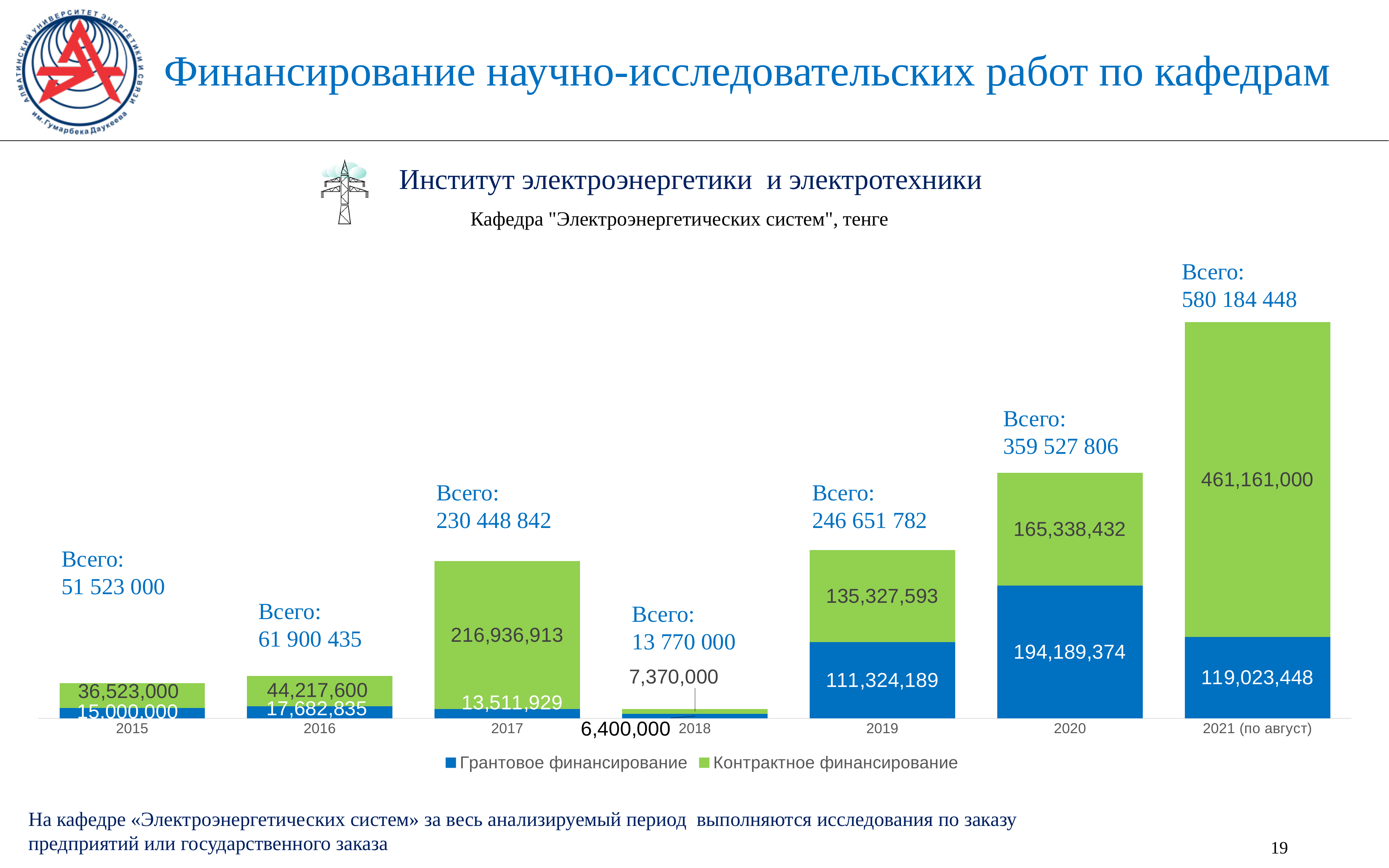
Which is larger in 2020: Грантовое финансирование or Контрактное финансирование? Грантовое финансирование Which year has the lowest total (Всего) funding? 2018 What is the value of Грантовое финансирование for 2019? 111,324,189 Which year has the highest Грантовое финансирование? 2020 How many years are shown on the x axis? 7 What is the total (Всего) funding shown for 2017? 230 448 842 Which year has the highest Контрактное финансирование? 2021 (по август) What kind of chart is shown on the slide? Stacked bar chart What is the difference between Грантовое финансирование and Контрактное финансирование in 2020? 28,850,942 What is the value of Грантовое финансирование for 2018? 6,400,000 What is the value of Контрактное финансирование for 2017? 216,936,913 How many series does the legend list? 2